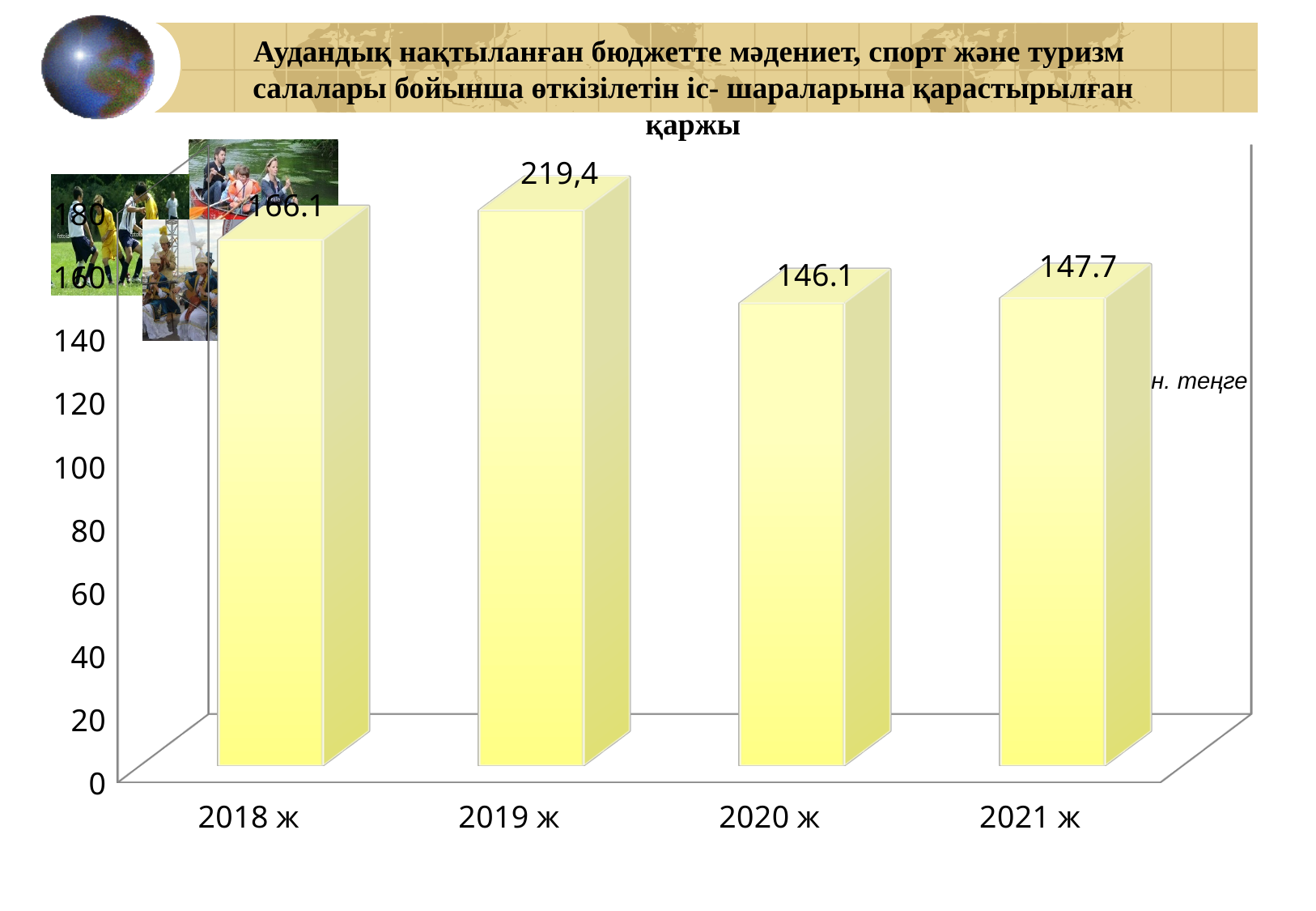
What is the value for 2021 ж? 147.7 What is the value for 2020 ж? 146.1 What kind of chart is shown on the slide? bar chart Which year has the highest value? 2019 ж What is the difference between the values for 2021 ж and 2020 ж? 1.6 What is the difference between the values for 2019 ж and 2020 ж? 73.3 What is the value for 2019 ж? 219,4 How many years are shown on the x axis? 4 Does the value rise or fall from 2019 ж to 2020 ж? fall Which is larger, the value for 2019 ж or the value for 2018 ж? 2019 ж Is the value for 2020 ж greater or less than 160? less Which year has the lowest value? 2020 ж